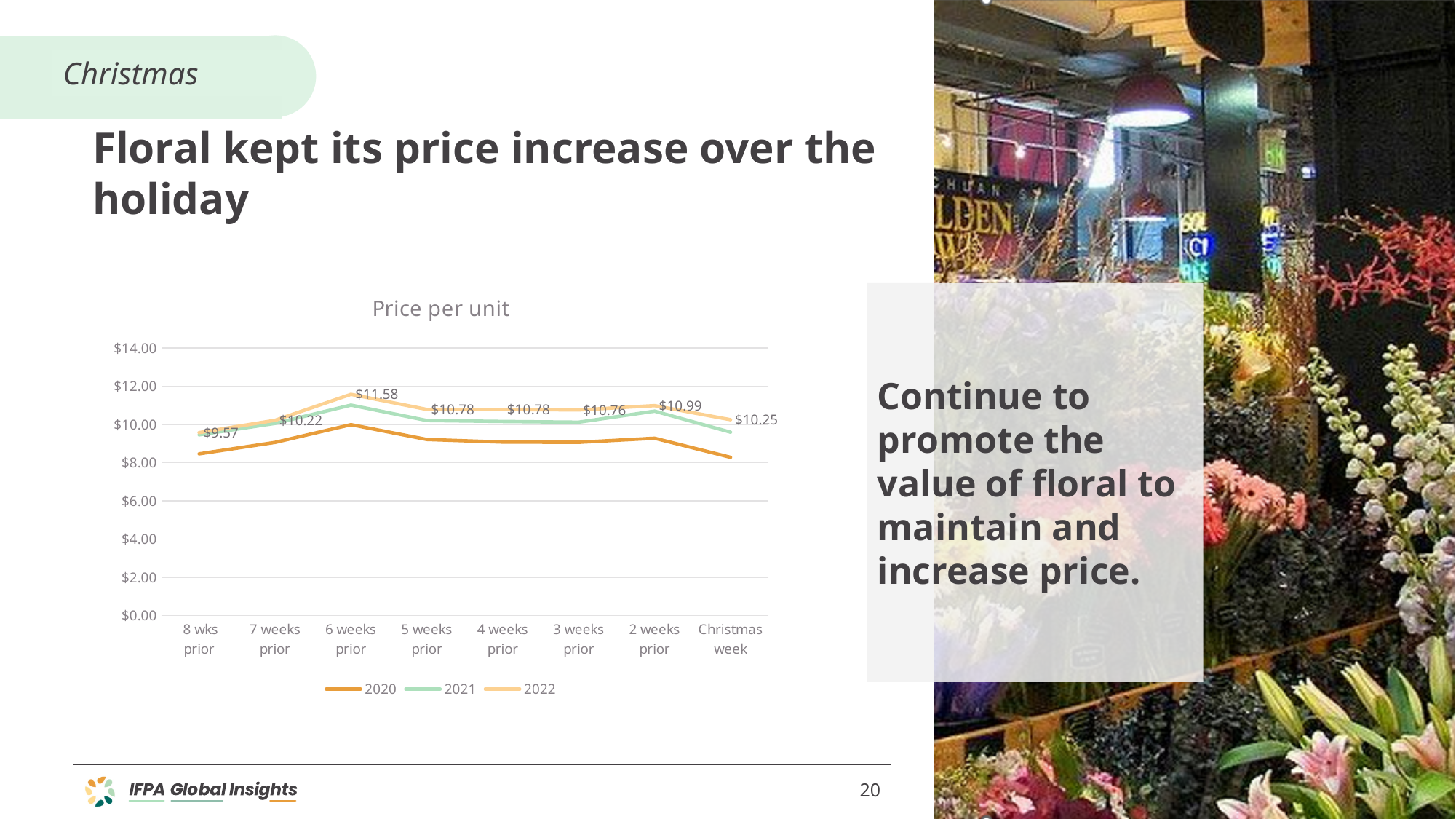
Is the 2020 price per unit during Christmas week greater or less than $10.00? less What type of chart is shown on the slide? line chart Which series has the lowest price per unit at 6 weeks prior: 2020 or 2022? 2020 What is the difference between the 2022 price at 6 weeks prior and at Christmas week? $1.33 At which time point is the 2022 price per unit lowest? 8 wks prior What is the title of the chart? Price per unit What is the 2022 price per unit at 6 weeks prior? $11.58 How many series does the legend list? 3 How many time points are plotted along the x axis? 8 What is the 2022 price per unit during Christmas week? $10.25 At which time point is the 2022 price per unit highest? 6 weeks prior What is the 2022 price per unit at 8 wks prior? $9.57